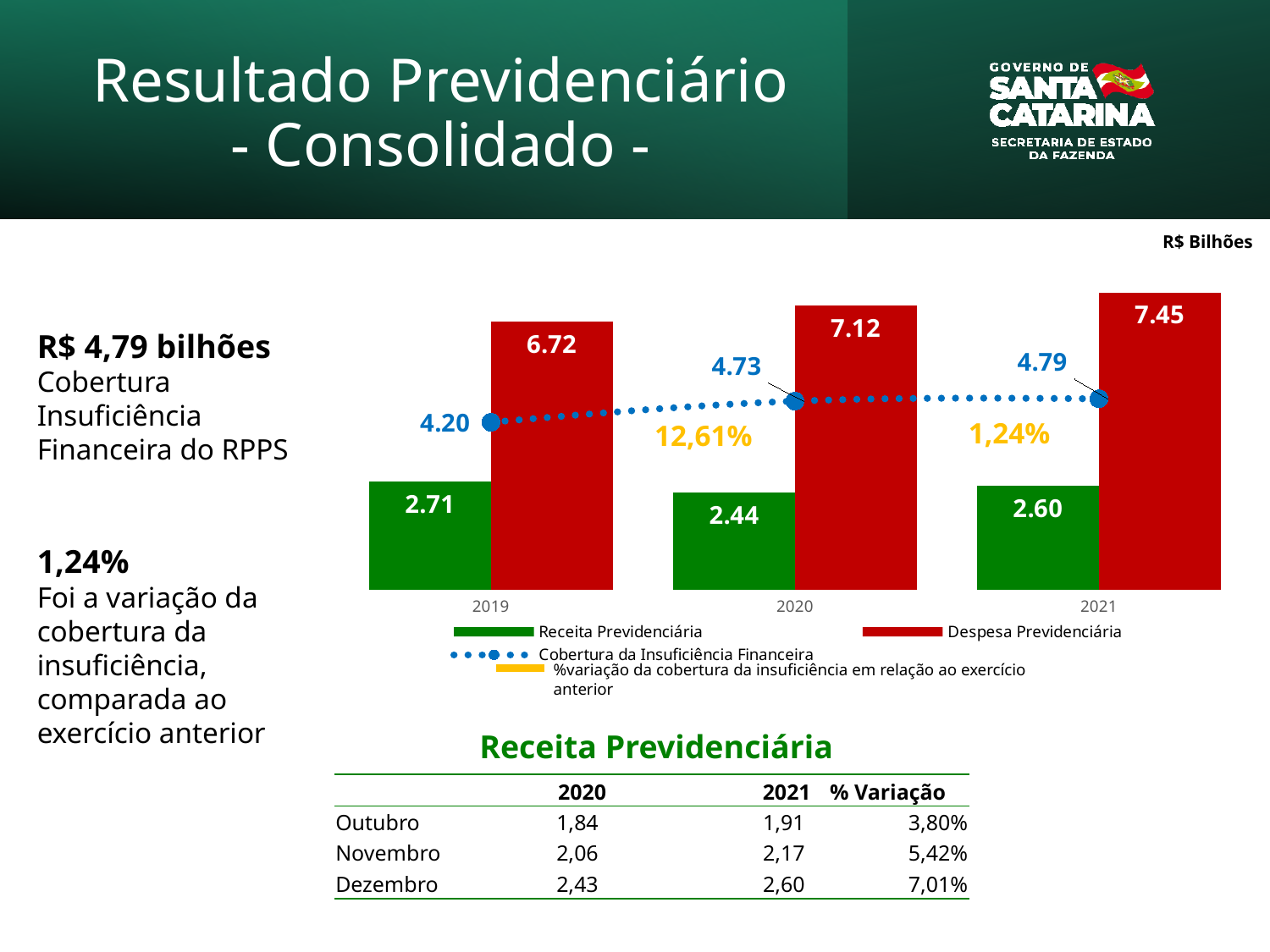
What is the value of Cobertura da Insuficiência Financeira for 2020? 4.73 Which year has the lowest Receita Previdenciária? 2020 What is the value of Despesa Previdenciária for 2021? 7.45 What is the difference between Despesa Previdenciária and Receita Previdenciária in 2020? 4.68 Is Receita Previdenciária higher in 2019 or in 2021? 2019 How many years are shown on the x axis of the chart? 3 How many series does the chart legend list? 4 What is the percentage variation of the cobertura da insuficiência shown for 2021? 1,24% Which year has the highest Despesa Previdenciária? 2021 What colour are the Receita Previdenciária bars in the chart? green Does Despesa Previdenciária rise or fall from 2019 to 2021? rise What is the value of Receita Previdenciária for 2019? 2.71